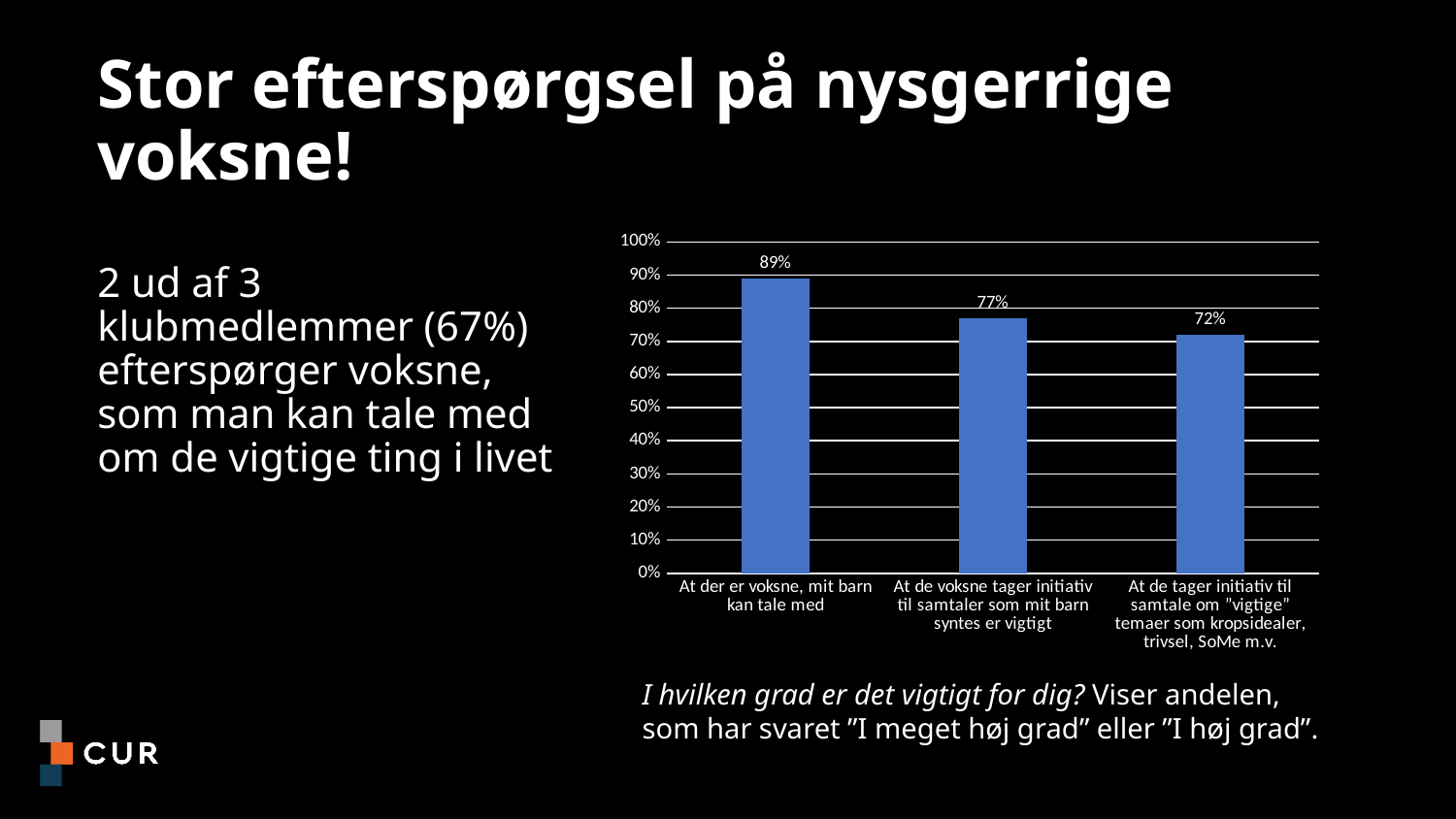
What is the value for "At de voksne tager initiativ til samtaler som mit barn syntes er vigtigt"? 77% Which category has the lowest value? At de tager initiativ til samtale om "vigtige" temaer som kropsidealer, trivsel, SoMe m.v. Is the value for "At de voksne tager initiativ til samtaler som mit barn syntes er vigtigt" greater or less than 80%? less Which is larger: the value for "At der er voksne, mit barn kan tale med" or the value for "At de tager initiativ til samtale om "vigtige" temaer som kropsidealer, trivsel, SoMe m.v."? At der er voksne, mit barn kan tale med What is the value for "At der er voksne, mit barn kan tale med"? 89% What is the difference between the values for "At der er voksne, mit barn kan tale med" and "At de voksne tager initiativ til samtaler som mit barn syntes er vigtigt"? 12% How many categories are shown in the chart? 3 Do the values rise or fall from left to right across the categories? Fall What is the value for "At de tager initiativ til samtale om "vigtige" temaer som kropsidealer, trivsel, SoMe m.v."? 72% What kind of chart is shown on the slide? Bar chart Which category has the highest value? At der er voksne, mit barn kan tale med What is the difference between the values for "At de voksne tager initiativ til samtaler som mit barn syntes er vigtigt" and "At de tager initiativ til samtale om "vigtige" temaer som kropsidealer, trivsel, SoMe m.v."? 5%